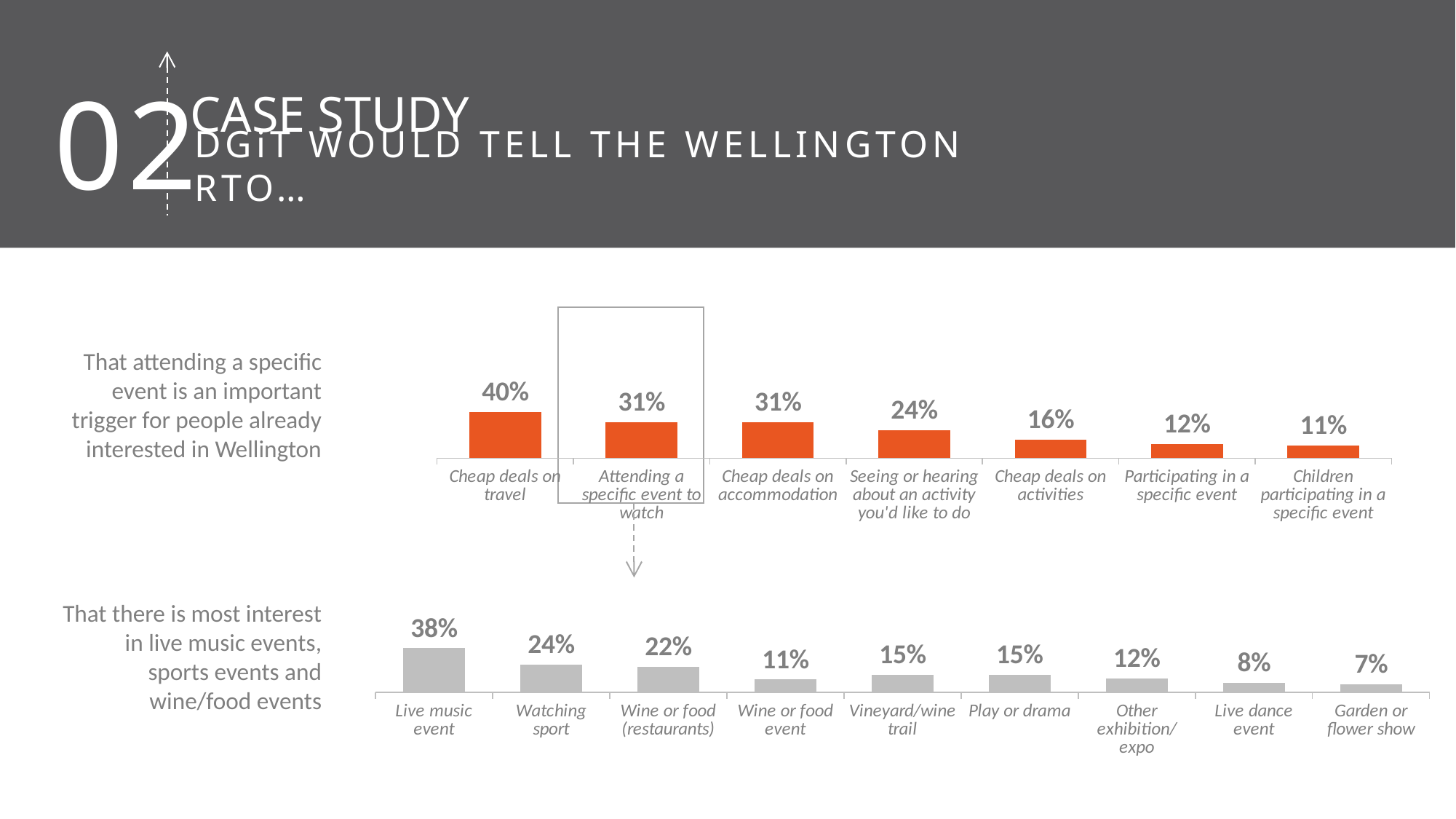
In the top chart, what is the value for Seeing or hearing about an activity you'd like to do? 24% What type of chart is the bottom chart? Bar chart In the bottom chart, what is the value for Live dance event? 8% In the bottom chart, how many categories are shown? 9 In the top chart, which category has the lowest value? Children participating in a specific event In the top chart, what is the value for Cheap deals on travel? 40% In the top chart, which is larger: Cheap deals on activities or Participating in a specific event? Cheap deals on activities In the bottom chart, what is the value for Live music event? 38% In the top chart, what is the difference between Cheap deals on travel and Attending a specific event to watch? 9% In the bottom chart, which category has the highest value? Live music event In the top chart, how many categories are shown? 7 In the bottom chart, which category has the lowest value? Garden or flower show